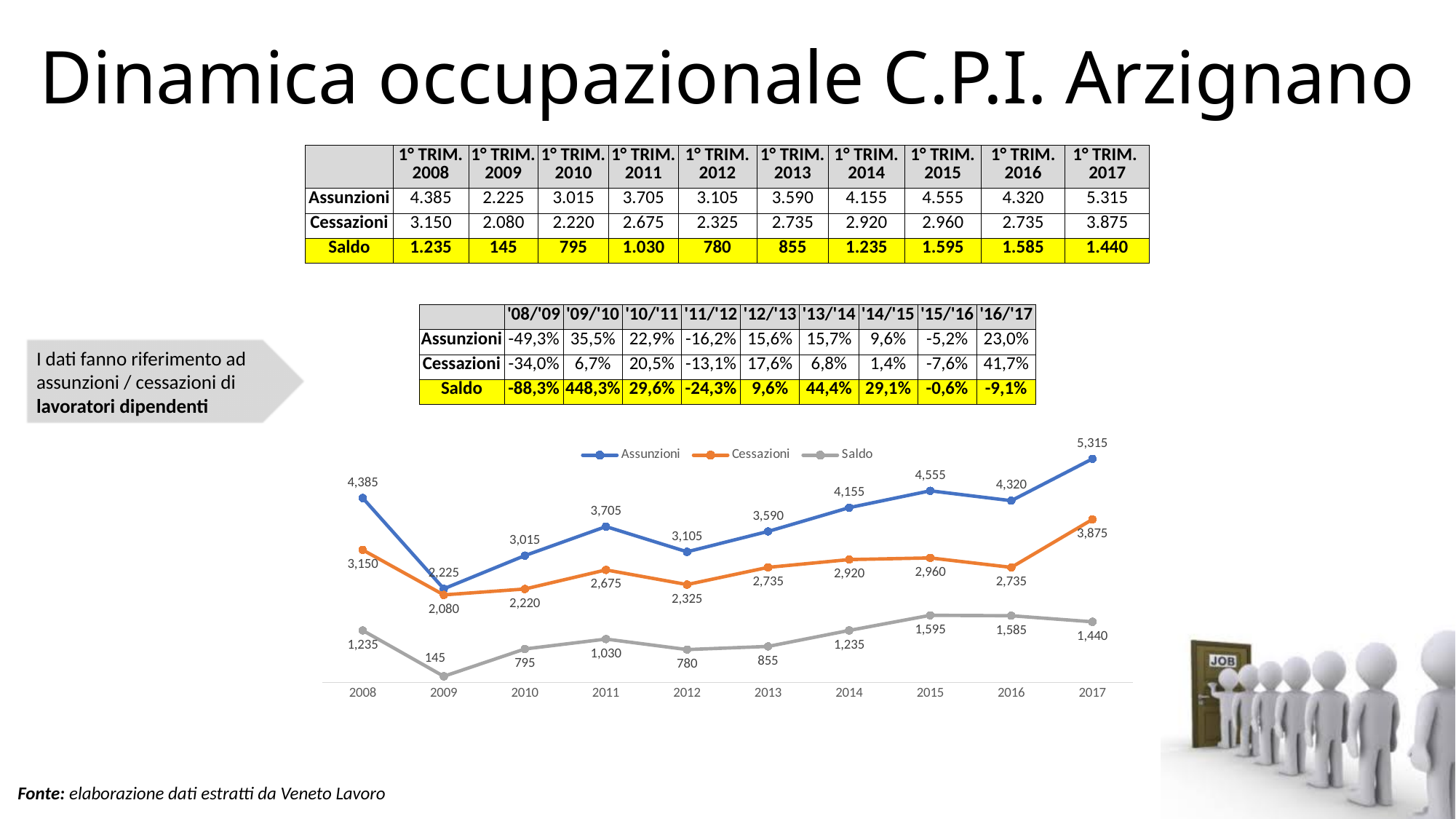
What is the value of Cessazioni in 2012 on the chart? 2,325 What is the value of Assunzioni in 2017 on the chart? 5,315 Does the Assunzioni series rise or fall between 2012 and 2015 on the chart? rise What kind of chart is shown on the slide? line chart In which year is Assunzioni highest on the chart? 2017 Which is larger on the chart: Cessazioni in 2008 or Cessazioni in 2016? Cessazioni in 2008 What is the difference between Assunzioni and Cessazioni in 2015 on the chart? 1,595 How many series does the chart legend list? 3 Which colour is used for the Cessazioni series in the chart? orange In which year is Saldo lowest on the chart? 2009 How many years are plotted along the x axis of the chart? 10 What is the value of Saldo in 2009 on the chart? 145